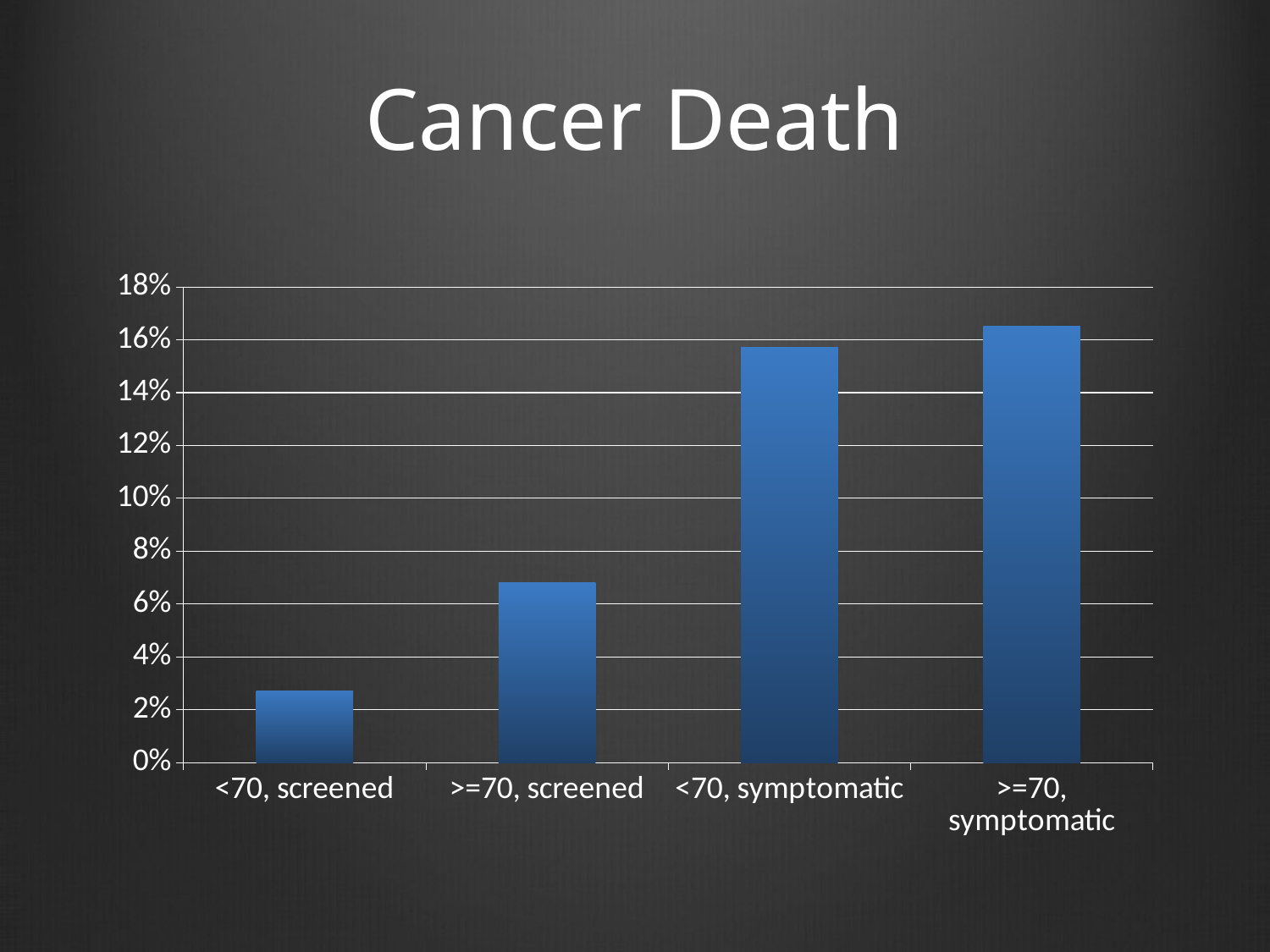
Which is larger, the value for >=70, screened or the value for <70, symptomatic? <70, symptomatic Do the values rise or fall from left to right along the x axis? rise Which category has the lowest value? <70, screened What is the highest value shown on the y axis? 18% Is the value for <70, symptomatic greater or less than 14%? greater How many categories are shown on the x axis? 4 Which category has the highest value? >=70, symptomatic Is the value for >=70, symptomatic greater or less than 16%? greater Is the value for <70, screened greater or less than 4%? less What type of chart is shown on the slide? bar chart What is the title of the chart? Cancer Death